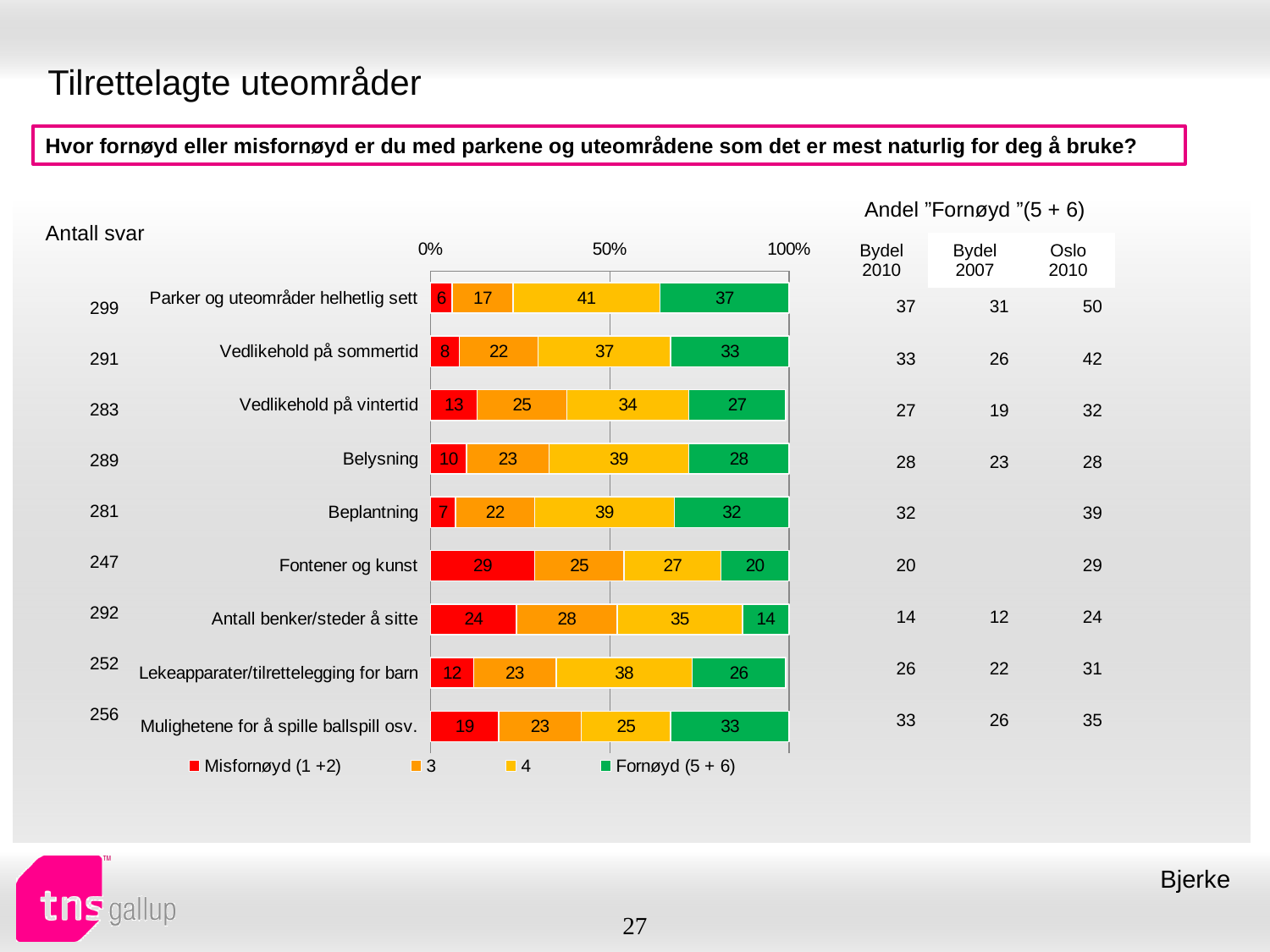
What is the total of the stacked bar for Vedlikehold på sommertid? 100 Which category has the highest Fornøyd (5 + 6) value? Parker og uteområder helhetlig sett What is the value of the Fornøyd (5 + 6) segment for Belysning? 28 How many categories are shown in the chart? 9 What kind of chart is shown on the slide? Stacked bar chart What is the value of the '4' segment for Lekeapparater/tilrettelegging for barn? 38 What is the difference between the Fornøyd (5 + 6) values for Parker og uteområder helhetlig sett and Antall benker/steder å sitte? 23 Which has the larger Misfornøyd (1 +2) value: Fontener og kunst or Antall benker/steder å sitte? Fontener og kunst How many series does the legend list? 4 What colour represents the Fornøyd (5 + 6) series in the chart? Green What is the value of the Misfornøyd (1 +2) segment for Fontener og kunst? 29 Which category has the lowest Fornøyd (5 + 6) value? Antall benker/steder å sitte